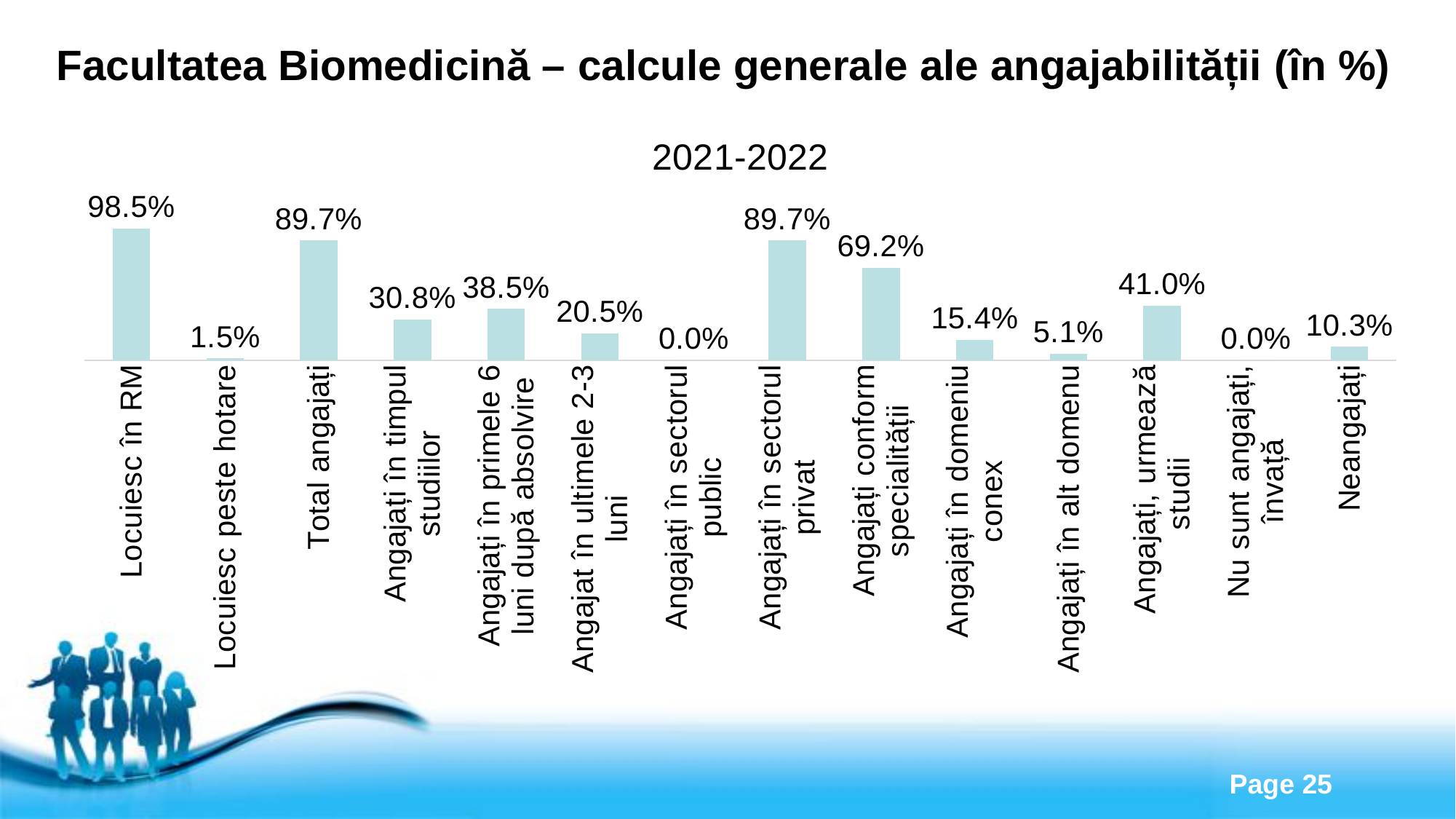
Which category has the highest value? Locuiesc în RM What kind of chart is shown on the slide? Bar chart What is the value for Neangajați? 10.3% Which is larger, Angajați în timpul studiilor or Angajați în primele 6 luni după absolvire? Angajați în primele 6 luni după absolvire What is the difference between Locuiesc în RM and Locuiesc peste hotare? 97.0% What is the value for Angajați în sectorul public? 0.0% What is the value for Locuiesc în RM? 98.5% What is the value for Angajați, urmează studii? 41.0% What is the title of the chart? 2021-2022 What is the difference between Angajați în sectorul privat and Angajați conform specialității? 20.5% How many categories are shown in the chart? 14 What is the value for Angajați conform specialității? 69.2%